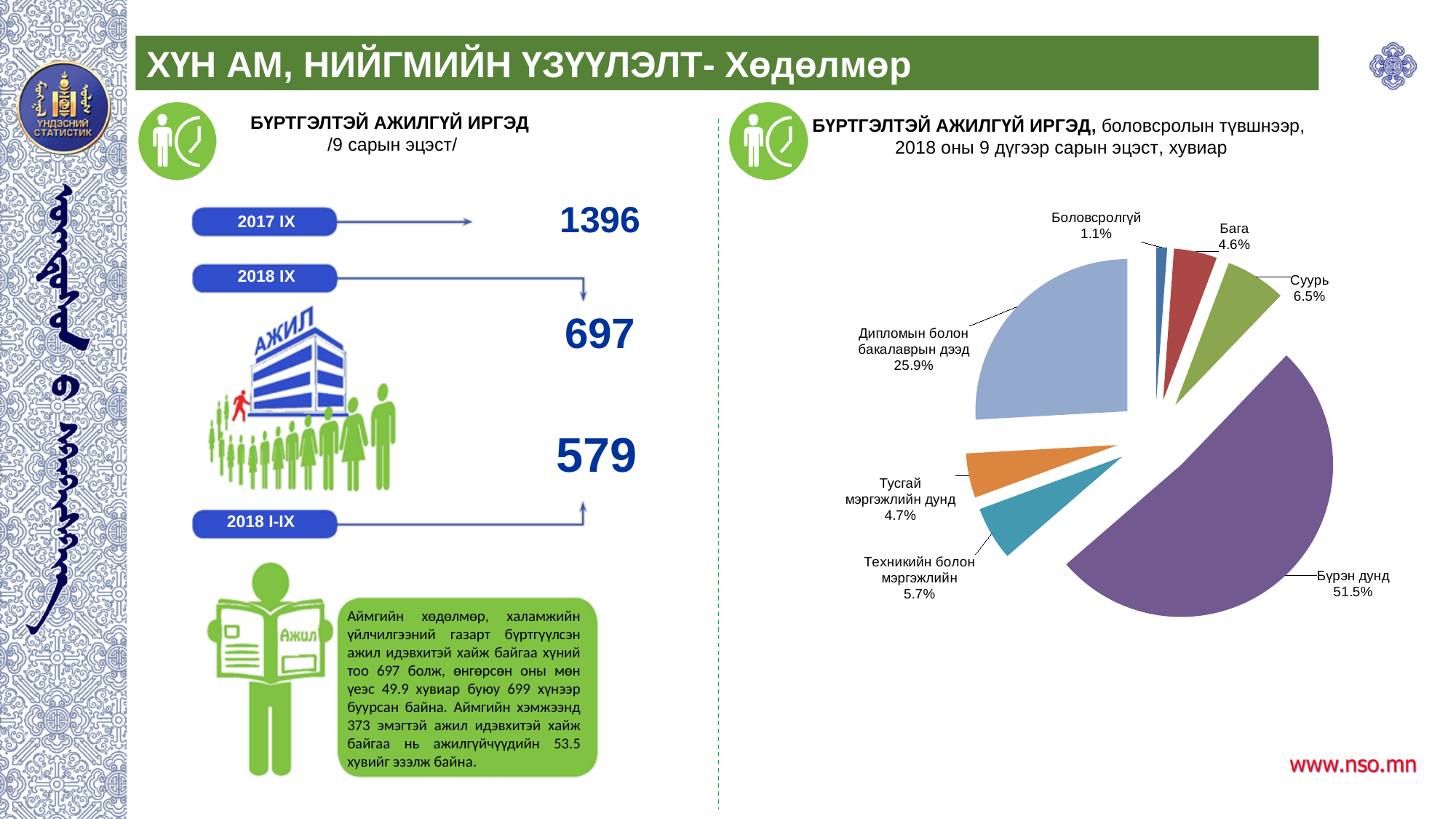
In the pie chart, what is the difference between the shares of Суурь and Тусгай мэргэжлийн дунд? 1.8% In the pie chart, what share is shown for Боловсролгүй? 1.1% In the pie chart, what is the difference between the shares of Бүрэн дунд and Дипломын болон бакалаврын дээд? 25.6% What kind of chart is shown on the right side of the slide? Pie chart In the pie chart, what share is shown for Техникийн болон мэргэжлийн? 5.7% What colour is the Бүрэн дунд slice in the pie chart? Purple How many slices does the pie chart have? 7 Which category has the smallest slice in the pie chart? Боловсролгүй In the pie chart, what share is shown for Бүрэн дунд? 51.5% Which category has the largest slice in the pie chart? Бүрэн дунд In the pie chart, which is larger: Суурь or Бага? Суурь In the pie chart, what share is shown for Дипломын болон бакалаврын дээд? 25.9%